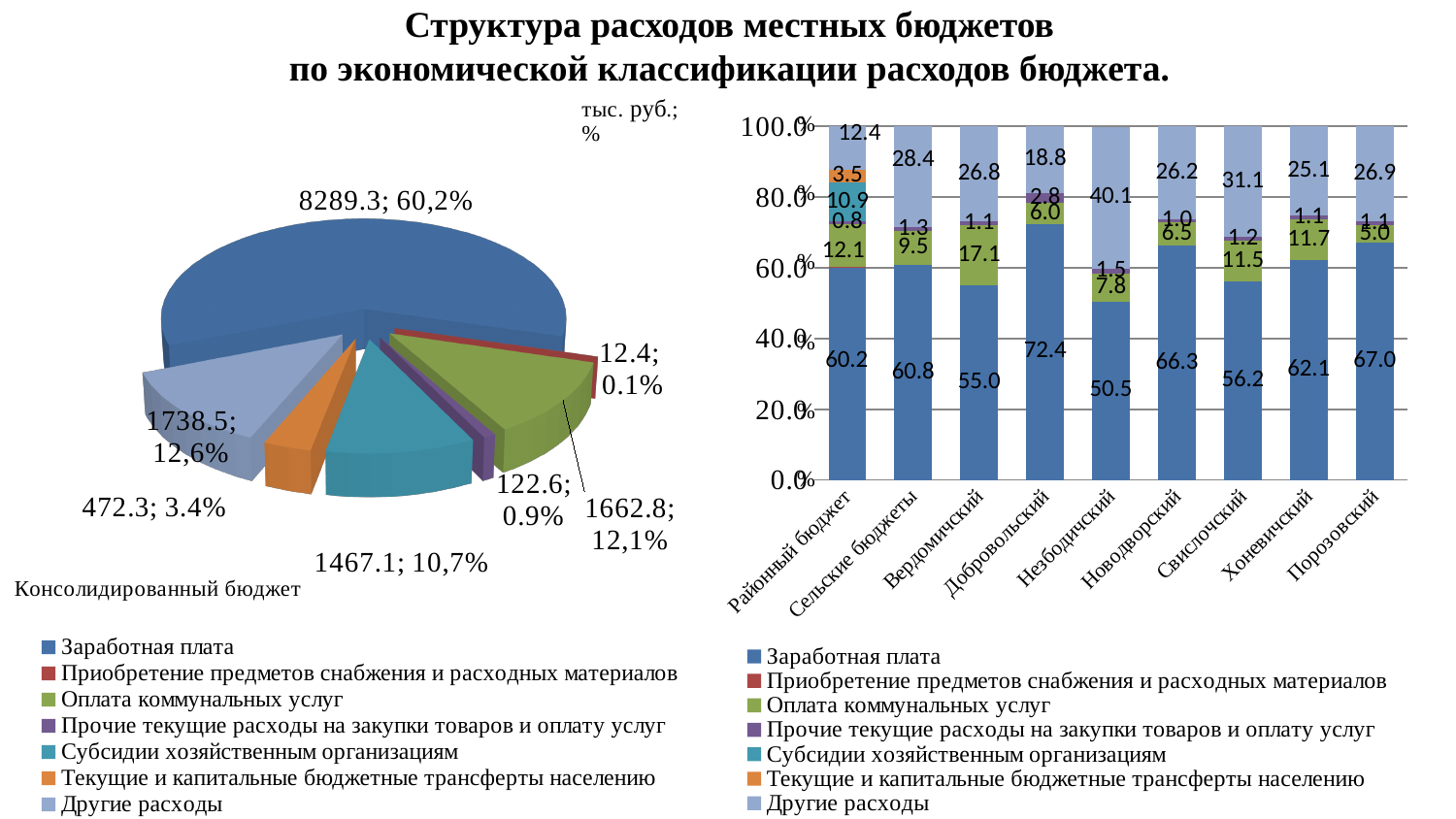
How many series does the legend of the stacked bar chart on the right list? 7 In the stacked bar chart on the right, how many categories are shown on the x axis? 9 In the stacked bar chart on the right, which category has the lowest value for Заработная плата? Незбодичский In the pie chart on the left, which category has the smallest slice? Приобретение предметов снабжения и расходных материалов In the stacked bar chart on the right, which is larger: Оплата коммунальных услуг for Вердомичский or for Свислочский? Вердомичский What type of chart is shown on the right side of the slide? Stacked bar chart In the pie chart on the left, how many slices are there? 7 In the pie chart on the left, what share does the slice labelled 1738.5 have? 12,6% In the stacked bar chart on the right, what is the difference between the Заработная плата values for Порозовский and Вердомичский? 12.0 In the pie chart on the left, what value is shown for the largest slice (Заработная плата)? 8289.3; 60,2% In the stacked bar chart on the right, what is the value of Заработная плата for Добровольский? 72.4 In the stacked bar chart on the right, which category has the highest value for Другие расходы? Незбодичский